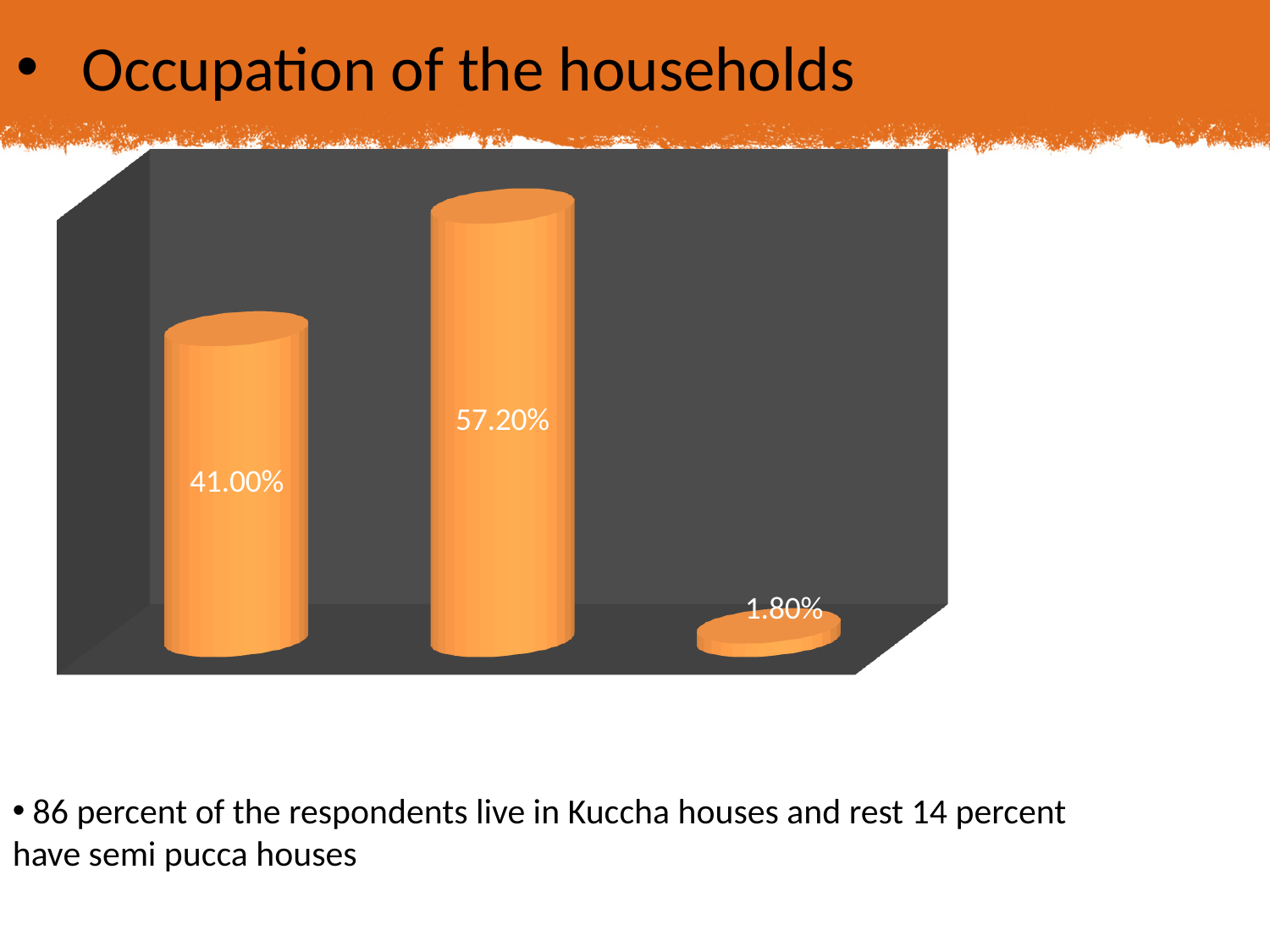
What value is labelled on the middle bar of the chart? 57.20% Which is larger, the value of the left bar or the value of the middle bar? the middle bar Which bar has the lowest value: the left, middle or right bar? right What value is labelled on the rightmost bar of the chart? 1.80% What value is labelled on the leftmost bar of the chart? 41.00% What is the total of the three values labelled on the chart? 100.00% What colour are the bars in the chart? orange Which bar has the highest value: the left, middle or right bar? middle What kind of chart is shown on the slide? bar chart What is the difference between the middle bar's value and the left bar's value? 16.20% How many bars does the chart show? 3 What is the difference between the left bar's value and the right bar's value? 39.20%